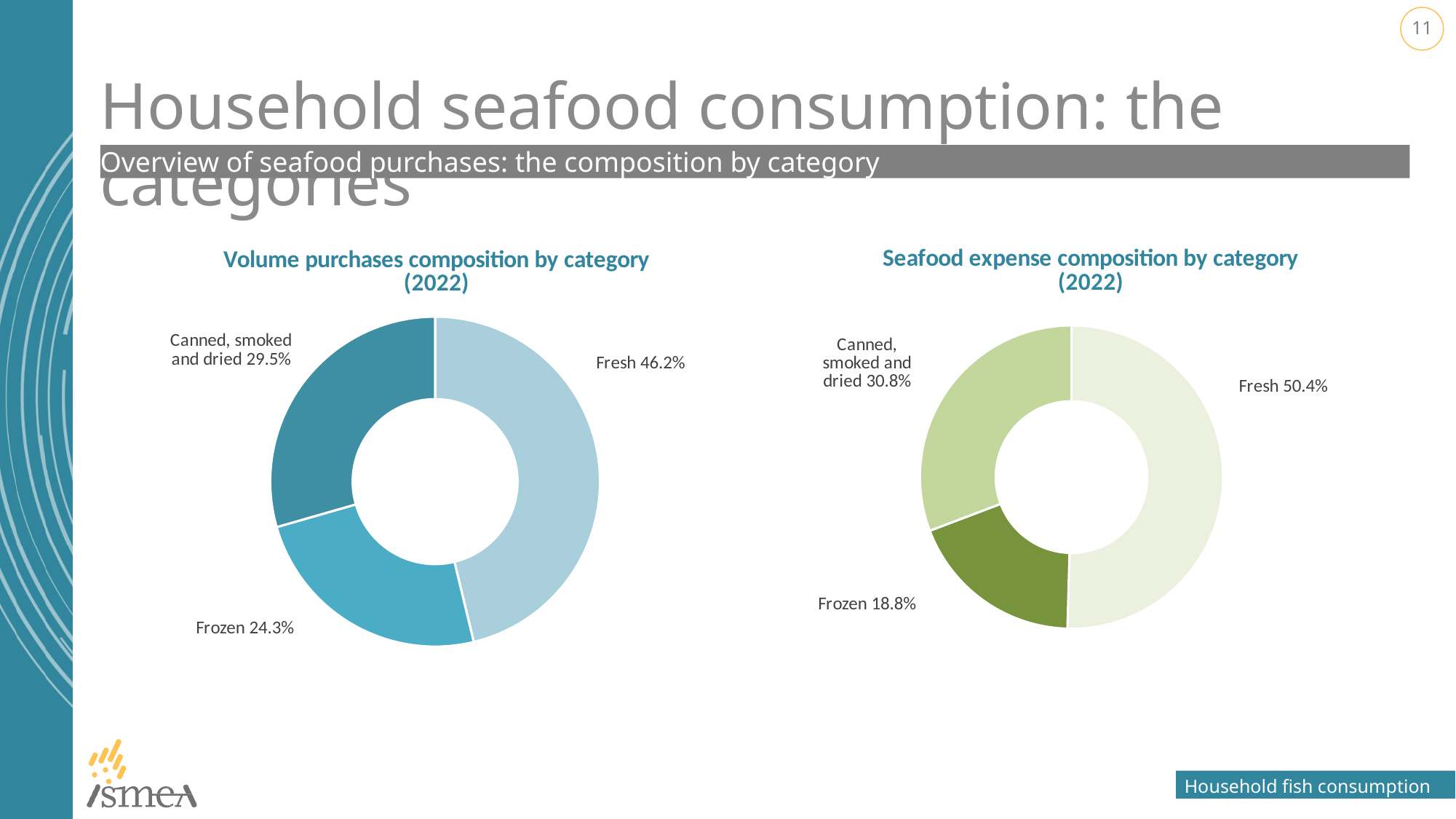
In the 'Seafood expense composition by category (2022)' chart, what is the share for Frozen? 18.8% In the 'Volume purchases composition by category (2022)' chart, what is the share for Fresh? 46.2% In the 'Seafood expense composition by category (2022)' chart, what is the difference between the Fresh share and the Canned, smoked and dried share? 19.6% In the 'Seafood expense composition by category (2022)' chart, which category has the smallest share? Frozen In the 'Volume purchases composition by category (2022)' chart, what is the share for Frozen? 24.3% In the 'Seafood expense composition by category (2022)' chart, what is the share for Canned, smoked and dried? 30.8% How many categories are shown in the 'Seafood expense composition by category (2022)' chart? 3 What kind of chart is the 'Volume purchases composition by category (2022)' chart? Doughnut chart In the 'Volume purchases composition by category (2022)' chart, what is the difference between the Fresh share and the Frozen share? 21.9% In the 'Volume purchases composition by category (2022)' chart, which category has the largest share? Fresh Which is larger: the Frozen share in the 'Volume purchases composition by category (2022)' chart or the Frozen share in the 'Seafood expense composition by category (2022)' chart? Volume purchases composition by category (2022) What is the title of the chart on the right side of the slide? Seafood expense composition by category (2022)